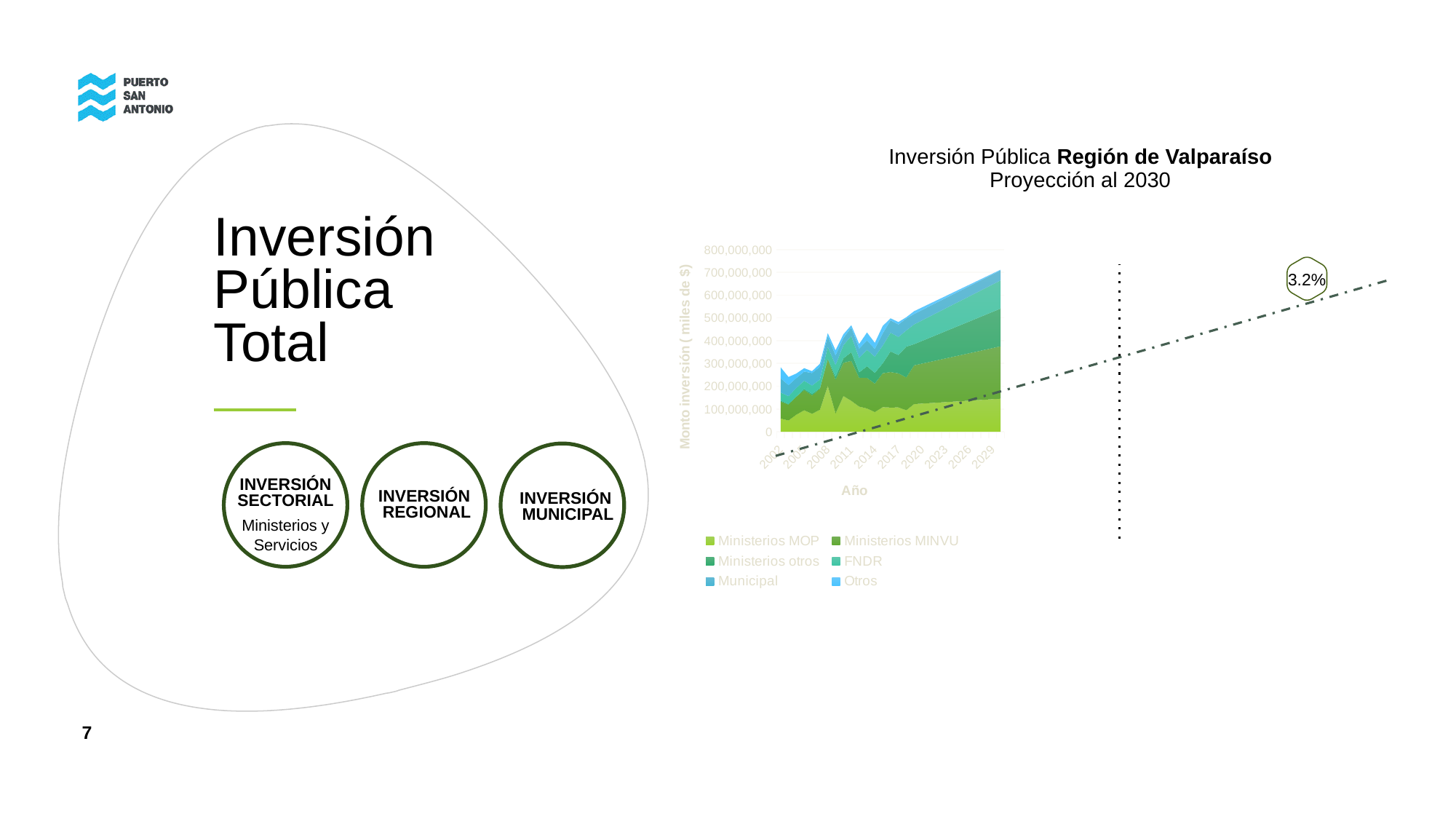
What is the title of the chart? Inversión Pública Región de Valparaíso Proyección al 2030 What is the first year shown on the chart's x axis? 2002 How many year labels are shown on the chart's x axis? 10 How many series does the chart legend list? 6 What is the last year labelled on the chart's x axis? 2029 What is the label of the chart's x axis? Año What kind of chart is shown on the slide? Stacked area chart Does the total stacked investment generally rise or fall from 2002 to 2029? Rise What is the highest value shown on the chart's y axis? 800,000,000 Which series is listed first in the chart legend? Ministerios MOP What is the label of the chart's y axis? Monto inversión ( miles de $) Is the total stacked value for 2029 greater or less than 600,000,000? greater